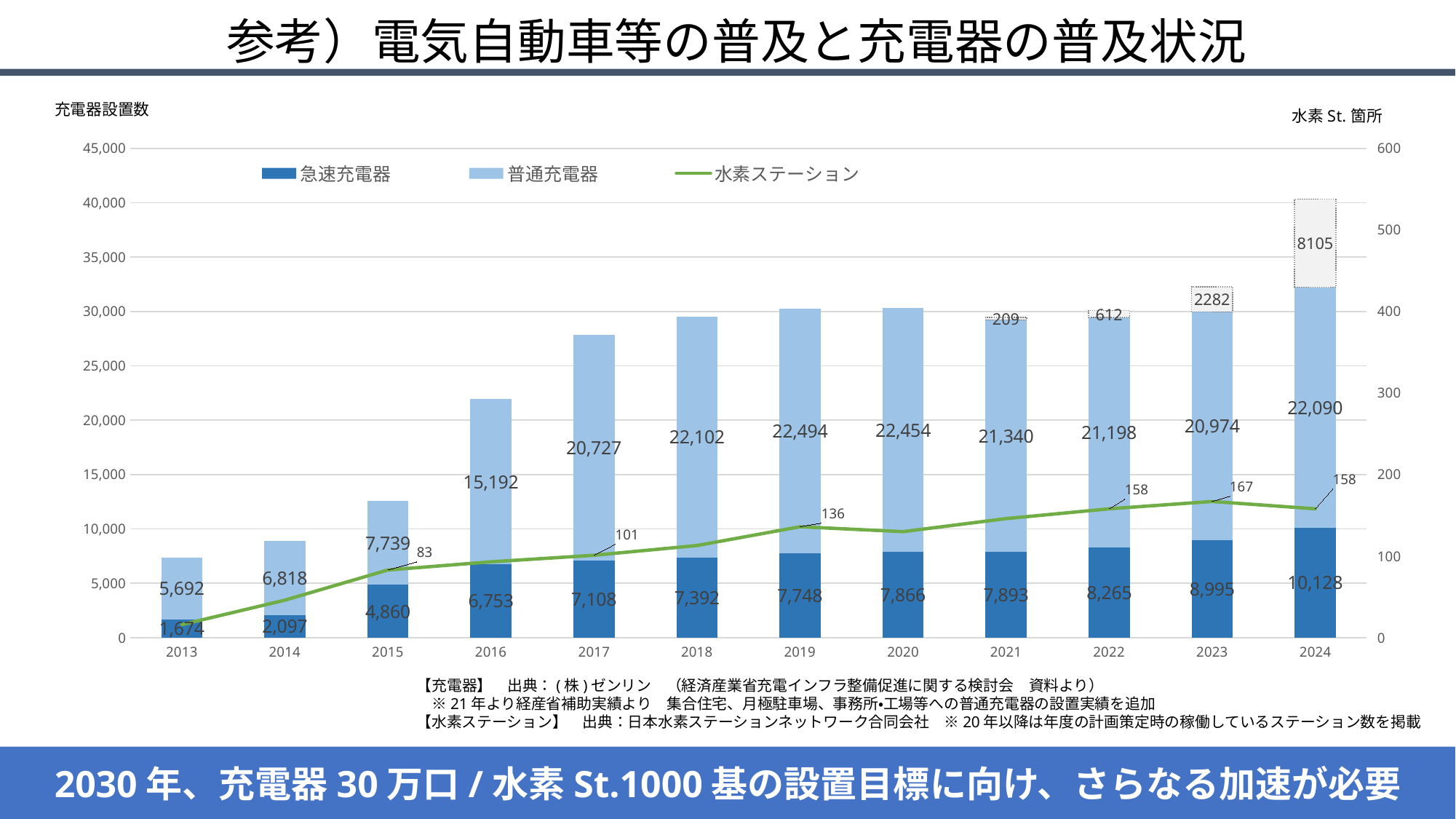
What is the value of 急速充電器 in 2024? 10,128 In which year is 急速充電器 highest? 2024 How many series does the legend list? 3 What is the value of 普通充電器 in 2017? 20,727 Is the total height of the 2016 stacked bar greater or less than 20,000? greater Which is larger, 普通充電器 in 2022 or in 2023? 2022 What is the value of 水素ステーション in 2023? 167 In which year is 普通充電器 lowest? 2013 What is the total of the 急速充電器 and 普通充電器 segments in 2013? 7,366 How many years are shown on the x axis? 12 Does 急速充電器 rise or fall from 2013 to 2024? rise What is the difference between 普通充電器 in 2019 and 2018? 392